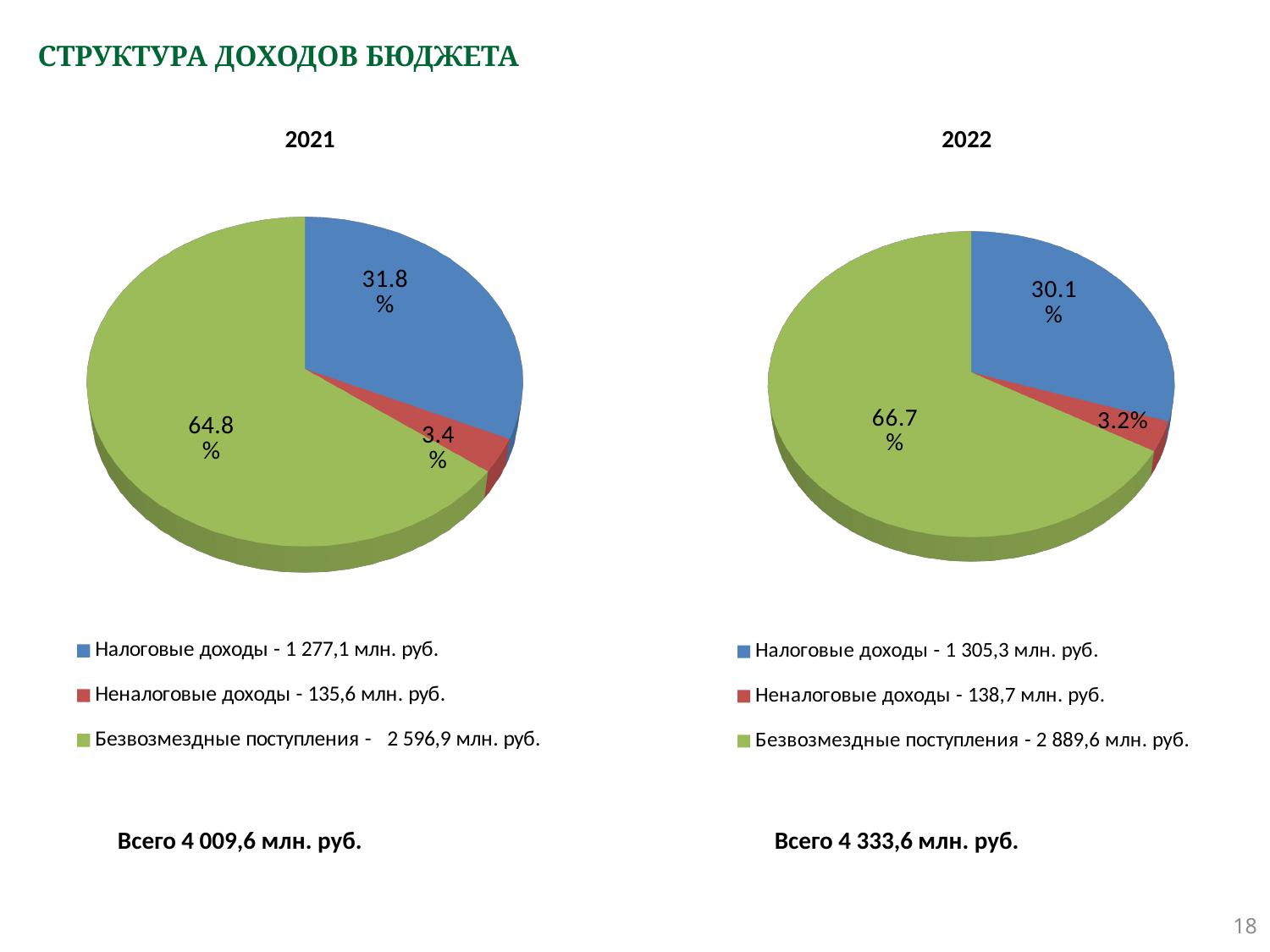
In the 2022 pie chart, which category has the largest slice? Безвозмездные поступления In the 2022 chart legend, what amount is given for Неналоговые доходы? 138,7 млн. руб. Which is larger: the Налоговые доходы share in 2021 or in 2022? 2021 What colour represents Налоговые доходы in the 2021 pie chart? Blue In the 2022 pie chart, what is the difference in percentage points between Безвозмездные поступления and Налоговые доходы? 36.6 What kind of chart is used for the 2022 data? Pie chart In the 2022 pie chart, what share does Налоговые доходы have? 30.1% In the 2021 pie chart, what share does Безвозмездные поступления have? 64.8% In the 2021 pie chart, which category has the smallest slice? Неналоговые доходы In the 2021 pie chart, what share does Неналоговые доходы have? 3.4% How many slices does the 2021 pie chart have? 3 In the 2021 chart legend, what amount is given for Безвозмездные поступления? 2 596,9 млн. руб.